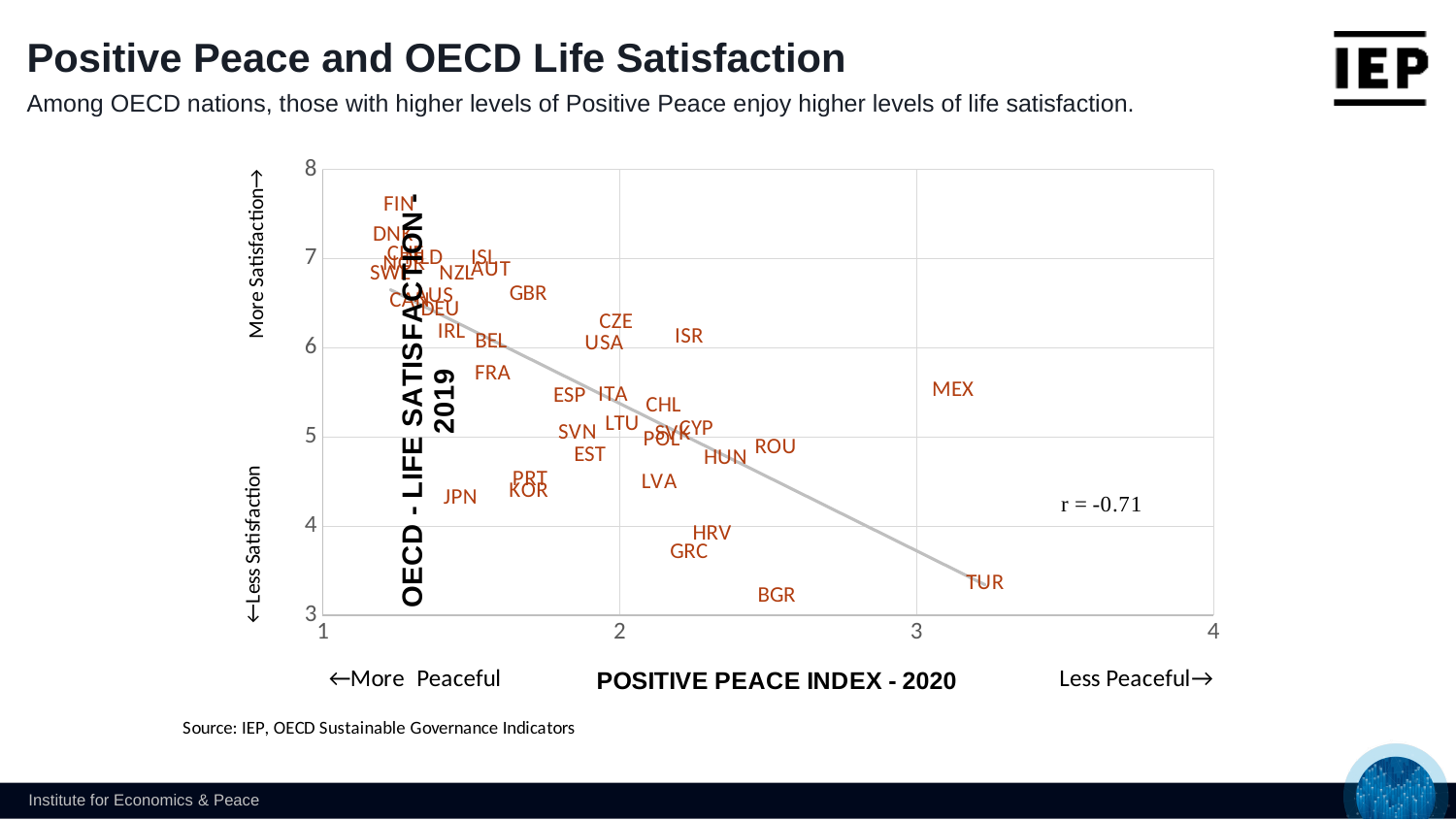
Is the life satisfaction value for MEX greater or less than 5? greater Is the Positive Peace Index value for ROU greater or less than 2? greater Is the life satisfaction value for BGR greater or less than 4? less Which country has the highest OECD life satisfaction value in the chart? FIN As the Positive Peace Index increases along the x axis, does life satisfaction generally rise or fall? fall Which has the higher life satisfaction value, GBR or JPN? GBR What correlation coefficient is printed on the chart? r = -0.71 What kind of chart is shown on the slide? scatter chart Which has the higher Positive Peace Index value, TUR or FIN? TUR